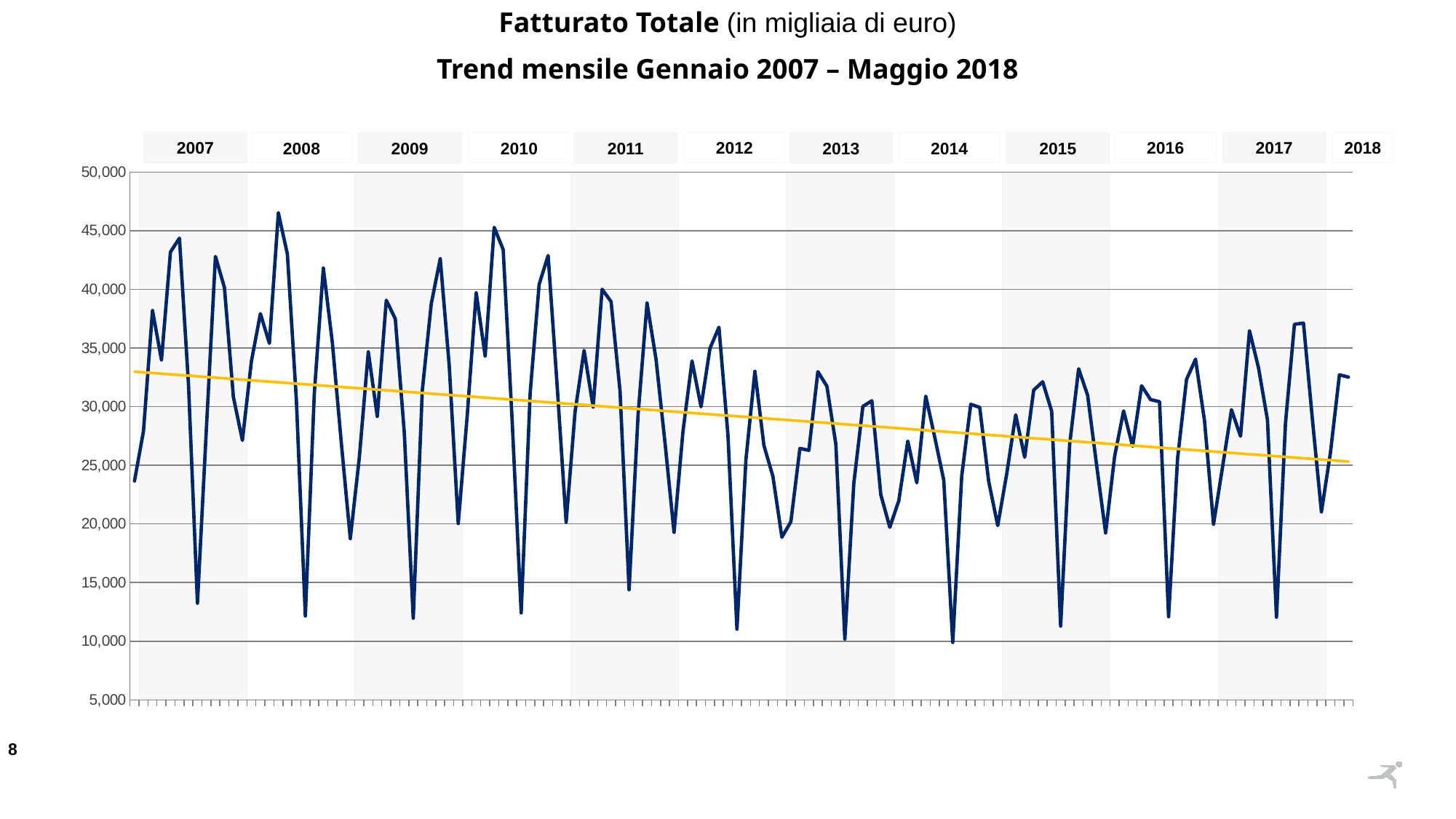
Is the highest peak of the monthly line in 2017 greater or less than 35,000? greater What is the lowest value shown on the vertical axis? 5,000 How many years are labelled along the top of the chart? 12 Is the highest peak of the monthly line in 2008 greater or less than 45,000? greater Is the highest peak in 2008 higher or lower than the highest peak in 2016? higher In which year does the monthly line reach its highest peak over the whole period? 2008 What kind of chart is shown on the slide? line chart Does the yellow trend line rise or fall from 2007 to 2018? fall Is the lowest dip of the monthly line in 2007 greater or less than 15,000? less What is the title of the chart? Fatturato Totale (in migliaia di euro) – Trend mensile Gennaio 2007 – Maggio 2018